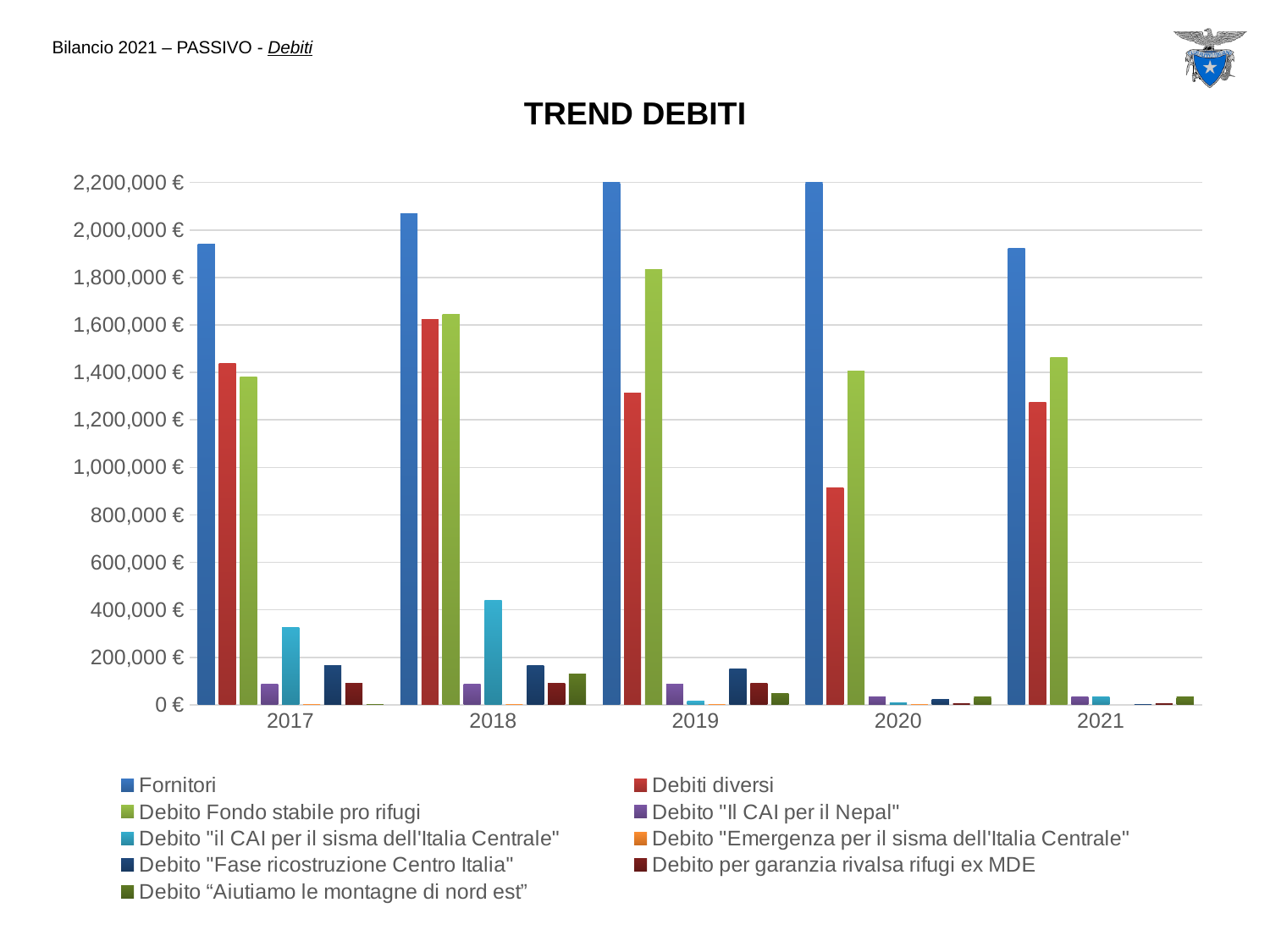
In 2021, which is larger: Debiti diversi or Debito Fondo stabile pro rifugi? Debito Fondo stabile pro rifugi In which year is the value for Debito "il CAI per il sisma dell'Italia Centrale" highest? 2018 What is the title of the chart? TREND DEBITI In which year is the value for Debiti diversi highest? 2018 Is the value for Fornitori in 2017 greater or less than 1,800,000 €? greater In which year is the value for Debito Fondo stabile pro rifugi highest? 2019 In which year is the value for Debiti diversi lowest? 2020 How many years are shown on the x axis of the chart? 5 How many series does the legend list? 9 Is the value for Debiti diversi in 2020 greater or less than 1,000,000 €? less Does the value for Debiti diversi rise or fall from 2018 to 2020? Fall What type of chart is shown on the slide? Bar chart